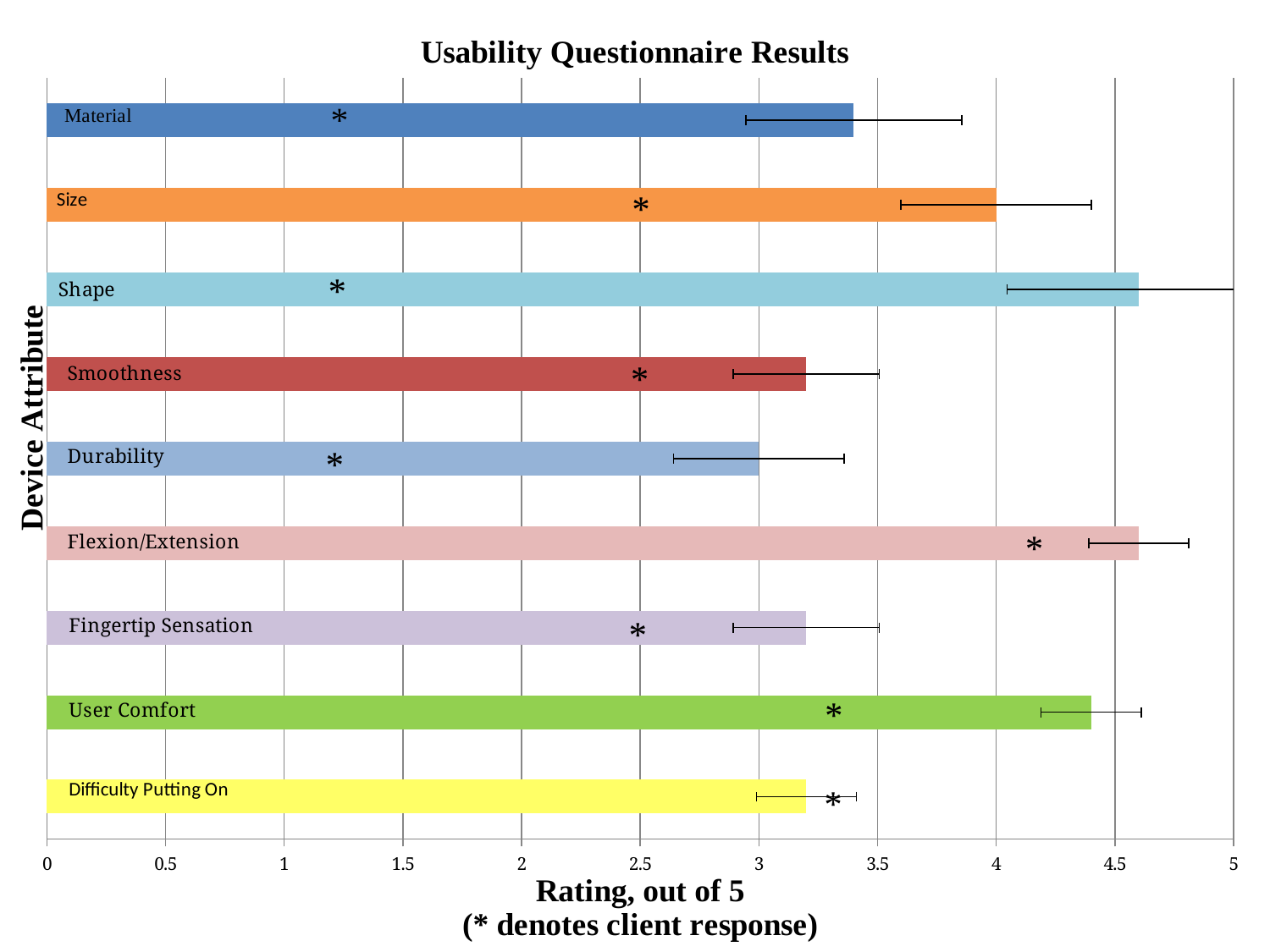
What type of chart is shown on the slide? bar chart What is the rating for Size? 4 Which has a higher rating, User Comfort or Smoothness? User Comfort Is the rating for Material greater or less than 3? greater Is the rating for User Comfort greater or less than 4.5? less According to the x-axis label, what does the asterisk (*) denote? client response Which device attribute has the lowest rating? Durability What is the difference between the ratings for Size and Durability? 1 How many device attributes are plotted in the chart? 9 Which has a higher rating, Size or Material? Size What is the rating for Durability? 3 What is the title of the chart? Usability Questionnaire Results